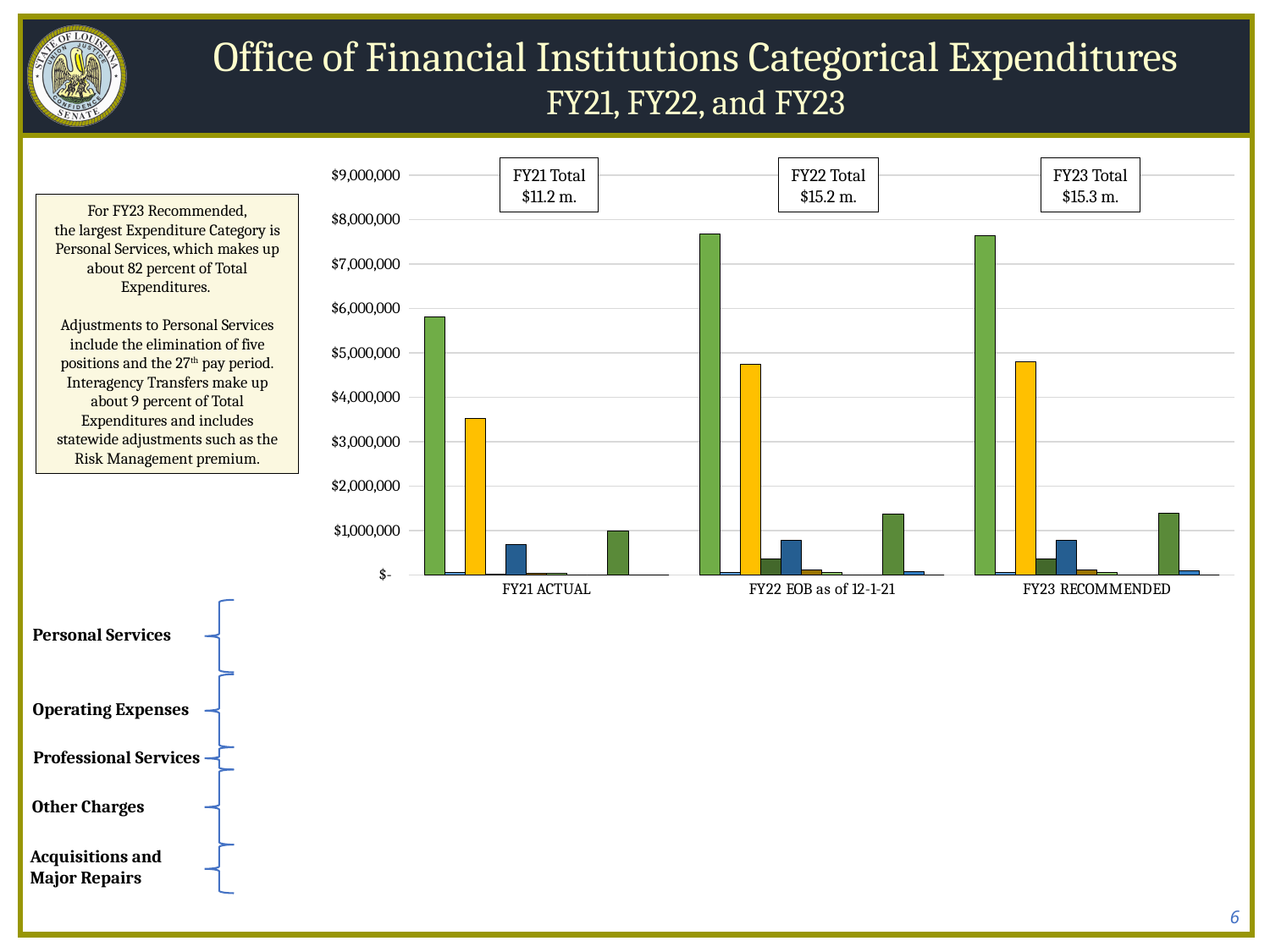
What kind of chart is shown on the slide? bar chart Is the tallest bar in the FY21 ACTUAL group greater or less than $5,000,000? greater Is the yellow bar in the FY21 ACTUAL group greater or less than $4,000,000? less Which fiscal year has the lowest total expenditures shown on the chart? FY21 How many fiscal-year groups are shown along the x axis of the chart? 3 Is the tallest bar in the FY22 EOB as of 12-1-21 group greater or less than $7,000,000? greater Do the fiscal-year totals shown on the chart rise or fall from FY21 to FY23? rise What is the difference between the FY22 Total and the FY21 Total shown on the chart? $4.0 m. What is the FY23 Total shown on the chart? $15.3 m. What is the FY22 Total shown on the chart? $15.2 m. What is the FY21 Total shown on the chart? $11.2 m. Which group has the taller light green bar, FY21 ACTUAL or FY23 RECOMMENDED? FY23 RECOMMENDED